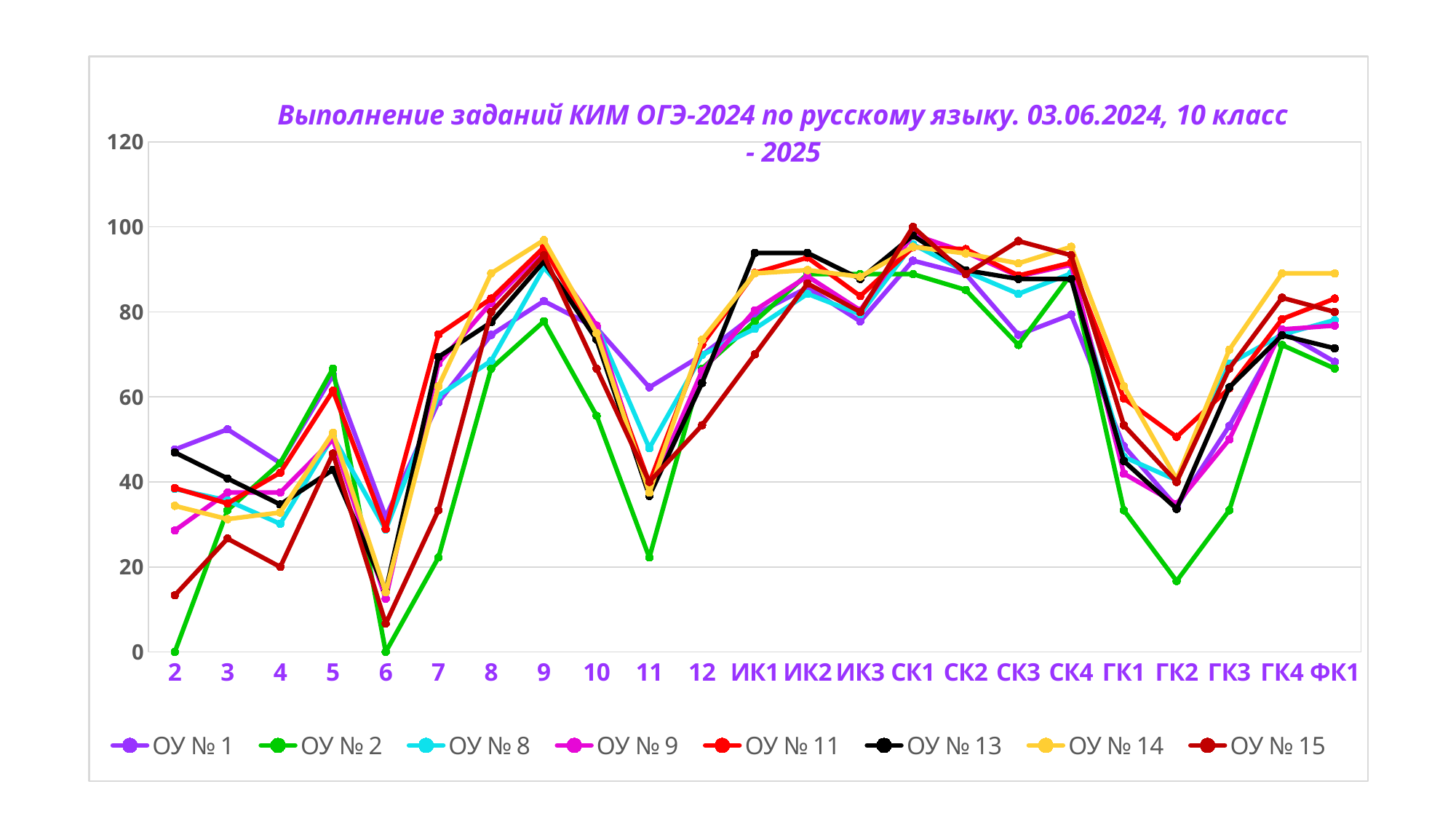
Does the value for ОУ № 2 rise or fall from category 6 to category 9? rise At category 11, which is larger: the value for ОУ № 1 or the value for ОУ № 2? ОУ № 1 Which series has the lowest value at ГК2? ОУ № 2 What colour is the line for ОУ № 2? green What is the value for ОУ № 2 at category 2? 0 How many categories are shown along the x axis? 23 Is the value for ОУ № 14 at category 9 greater or less than 80? greater Which series has the highest value at category 3? ОУ № 1 Is the value for ОУ № 2 at ГК2 greater or less than 20? less What kind of chart is shown on the slide? line chart Is the value for ОУ № 15 at category 2 greater or less than 20? less How many series does the legend list? 8